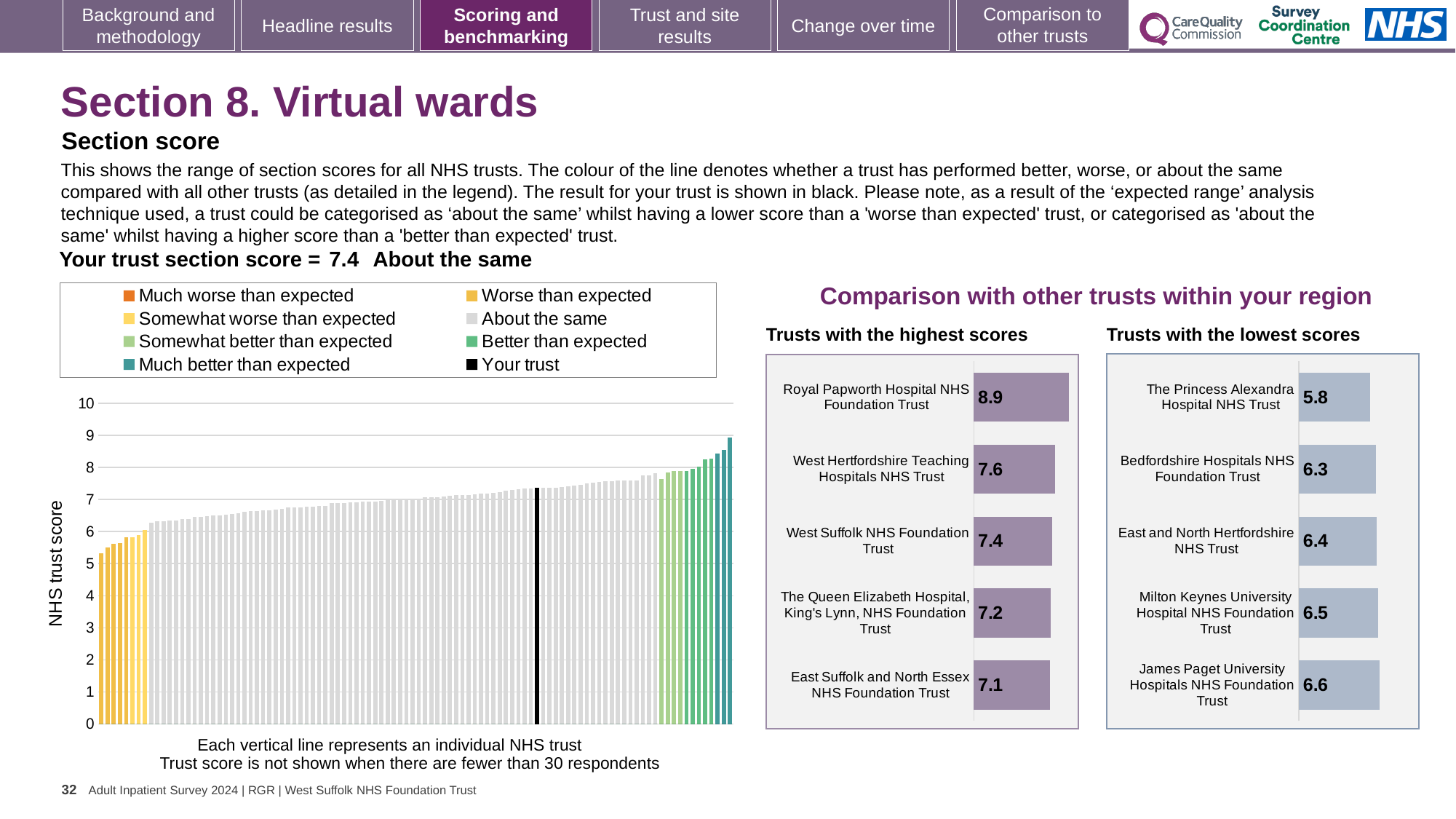
In the 'Trusts with the lowest scores' chart, what is the difference between the scores of James Paget University Hospitals NHS Foundation Trust and Bedfordshire Hospitals NHS Foundation Trust? 0.3 In the main NHS trust score chart on the left, do the bar values rise or fall from left to right? rise In the main NHS trust score chart on the left, is the value of the tallest bar greater or less than 8? greater In the 'Trusts with the highest scores' chart, what is the score for Royal Papworth Hospital NHS Foundation Trust? 8.9 In the main NHS trust score chart on the left, what is the section score for your trust (the black bar)? 7.4 In the 'Trusts with the lowest scores' chart, what is the score for Milton Keynes University Hospital NHS Foundation Trust? 6.5 In the 'Trusts with the highest scores' chart, which has a higher score: West Hertfordshire Teaching Hospitals NHS Trust or The Queen Elizabeth Hospital, King's Lynn, NHS Foundation Trust? West Hertfordshire Teaching Hospitals NHS Trust How many entries does the legend of the main NHS trust score chart list? 8 In the 'Trusts with the lowest scores' chart, which trust has the lowest score? The Princess Alexandra Hospital NHS Trust In the 'Trusts with the highest scores' chart, which trust has the lowest score shown? East Suffolk and North Essex NHS Foundation Trust How many trusts are listed in the 'Trusts with the lowest scores' chart? 5 In the 'Trusts with the highest scores' chart, what is the difference between the scores of Royal Papworth Hospital NHS Foundation Trust and West Suffolk NHS Foundation Trust? 1.5